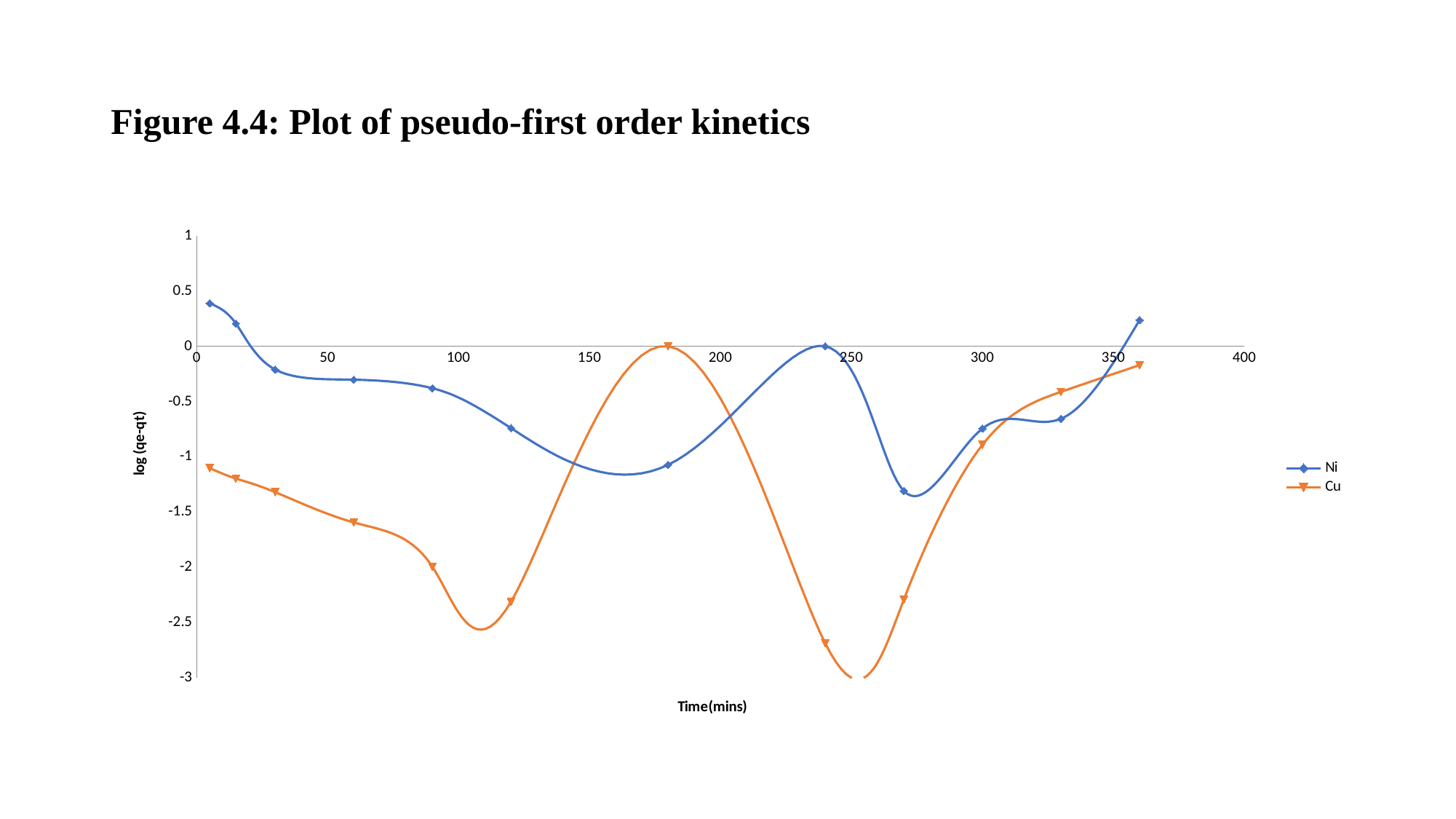
At which time does the Cu series reach its highest value? 180 mins What are the two series named in the legend? Ni and Cu Is the Ni value at 120 mins greater or less than -0.5? less How many series does the legend list? 2 Is the Cu value at 60 mins greater or less than -1.5? less What kind of chart is shown on the slide? line chart Does the Cu series rise or fall between 0 and 120 mins? fall How many data points are plotted for the Cu series? 12 At 60 mins, which series has the higher value, Ni or Cu? Ni What is the label of the x axis? Time(mins) At which time does the Cu series reach its lowest value? 240 mins At which time does the Ni series reach its lowest value? 270 mins